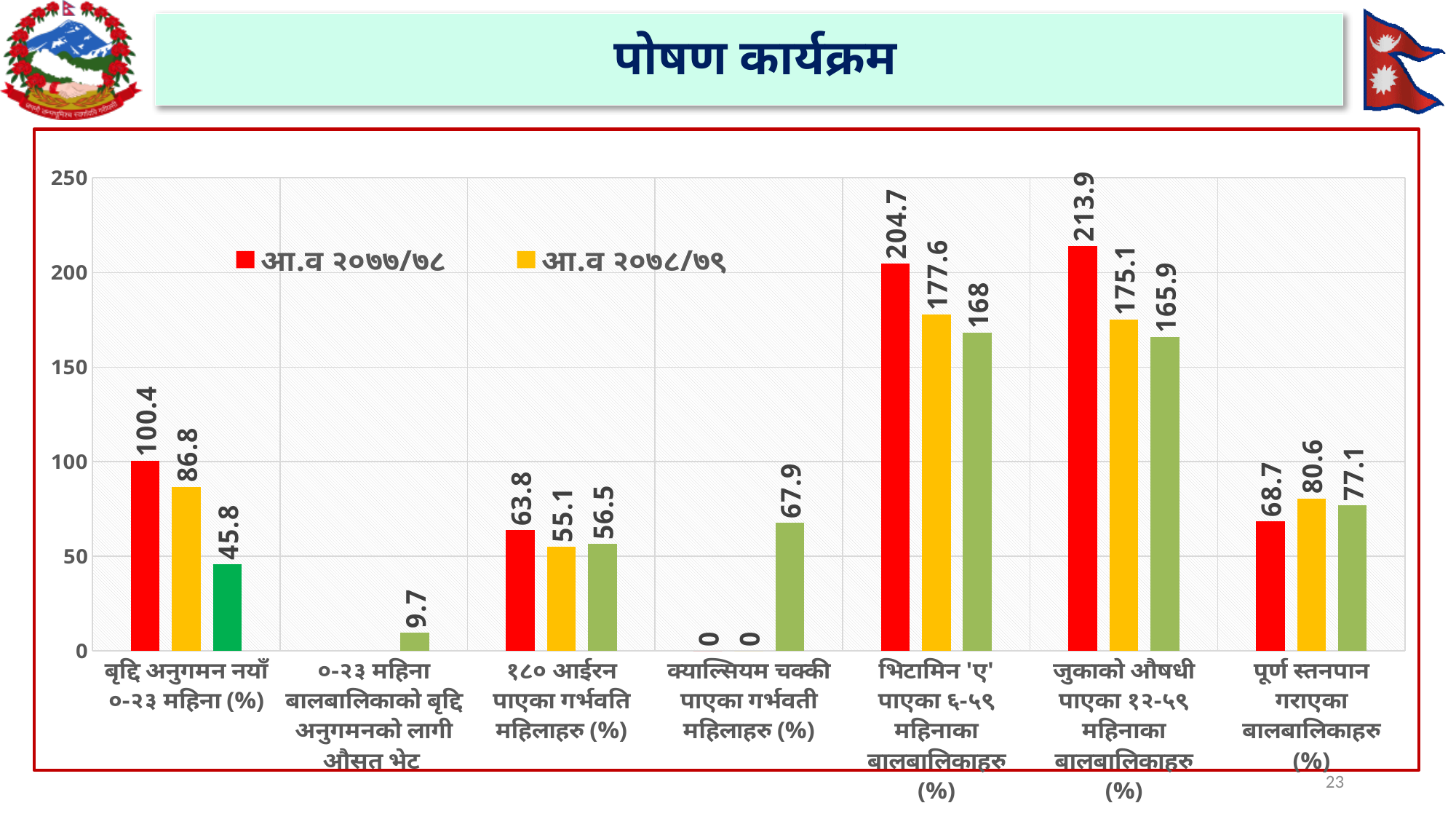
What is the value for आ.व २०७८/७९ in the category १८० आईरन पाएका गर्भवति महिलाहरु (%)? 55.1 For पूर्ण स्तनपान गराएका बालबालिकाहरु (%), which is larger: आ.व २०७७/७८ or आ.व २०७८/७९? आ.व २०७८/७९ What type of chart is shown on the slide? bar chart How many categories are shown on the x axis? 7 What colour represents आ.व २०७७/७८ in the legend? red Which category has the lowest value for आ.व २०७८/७९? क्याल्सियम चक्की पाएका गर्भवती महिलाहरु (%) Is the आ.व २०७७/७८ value for जुकाको औषधी पाएका १२-५९ महिनाका बालबालिकाहरु (%) greater or less than 200? greater What is the value for आ.व २०७८/७९ in the category पूर्ण स्तनपान गराएका बालबालिकाहरु (%)? 80.6 What is the value for आ.व २०७७/७८ in the category भिटामिन 'ए' पाएका ६-५९ महिनाका बालबालिकाहरु (%)? 204.7 What is the difference between the आ.व २०७७/७८ and आ.व २०७८/७९ values for बृद्धि अनुगमन नयाँ ०-२३ महिना (%)? 13.6 How many series does the legend list? 2 Which category has the highest value for आ.व २०७७/७८? जुकाको औषधी पाएका १२-५९ महिनाका बालबालिकाहरु (%)